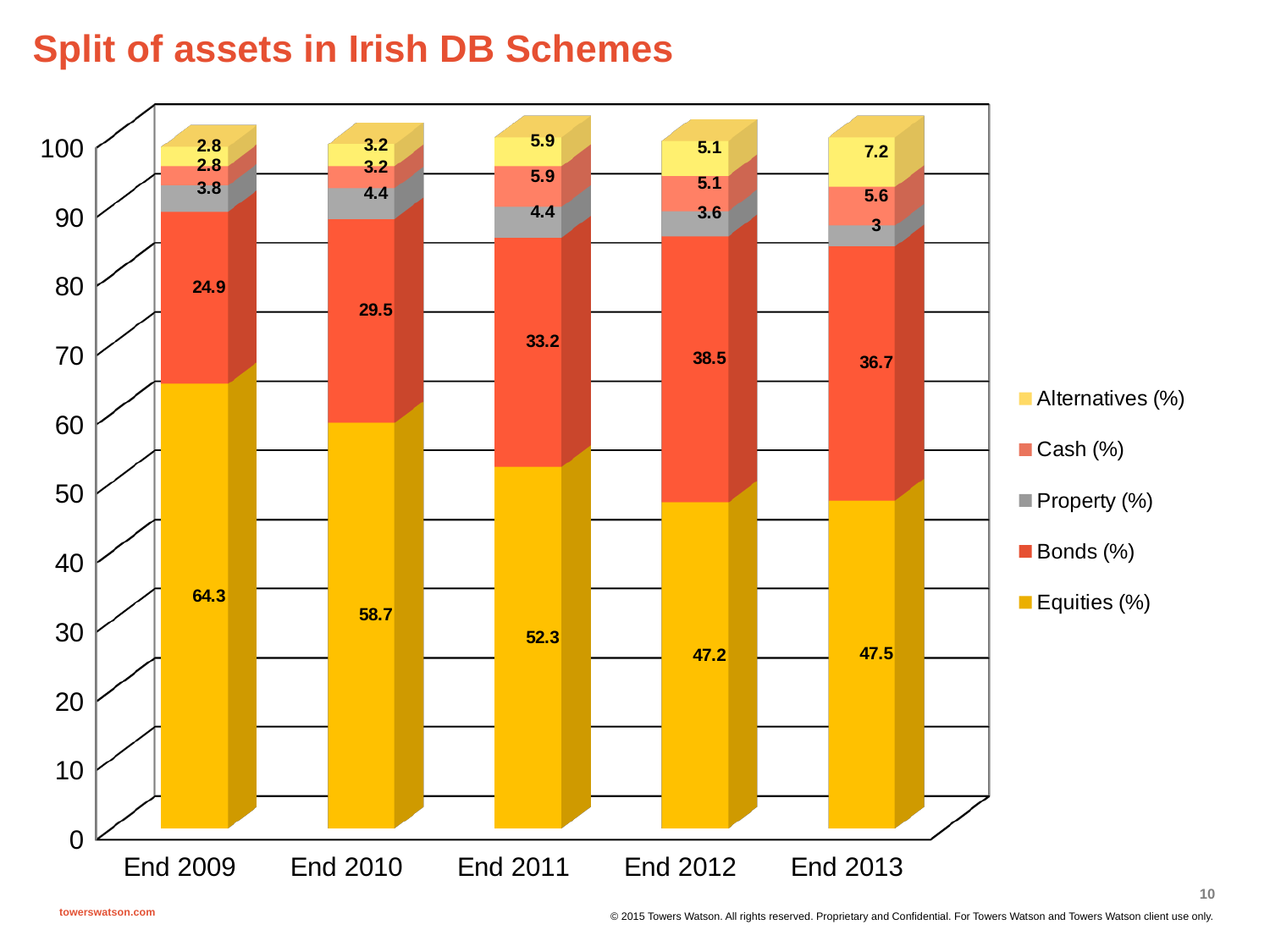
How many years are shown on the x axis? 5 Do the Bonds (%) values rise or fall from End 2009 to End 2012? Rise What is the Bonds (%) value for End 2012? 38.5 What is the Equities (%) value for End 2009? 64.3 In which year is the Property (%) value lowest? End 2013 What is the Alternatives (%) value for End 2013? 7.2 What kind of chart is shown on the slide? Stacked bar chart In which year is the Equities (%) value highest? End 2009 What is the difference between the Bonds (%) value for End 2013 and for End 2009? 11.8 What is the total of the stacked bar for End 2013? 100 Which year has the larger Equities (%) value, End 2012 or End 2013? End 2013 How many series does the legend list? 5